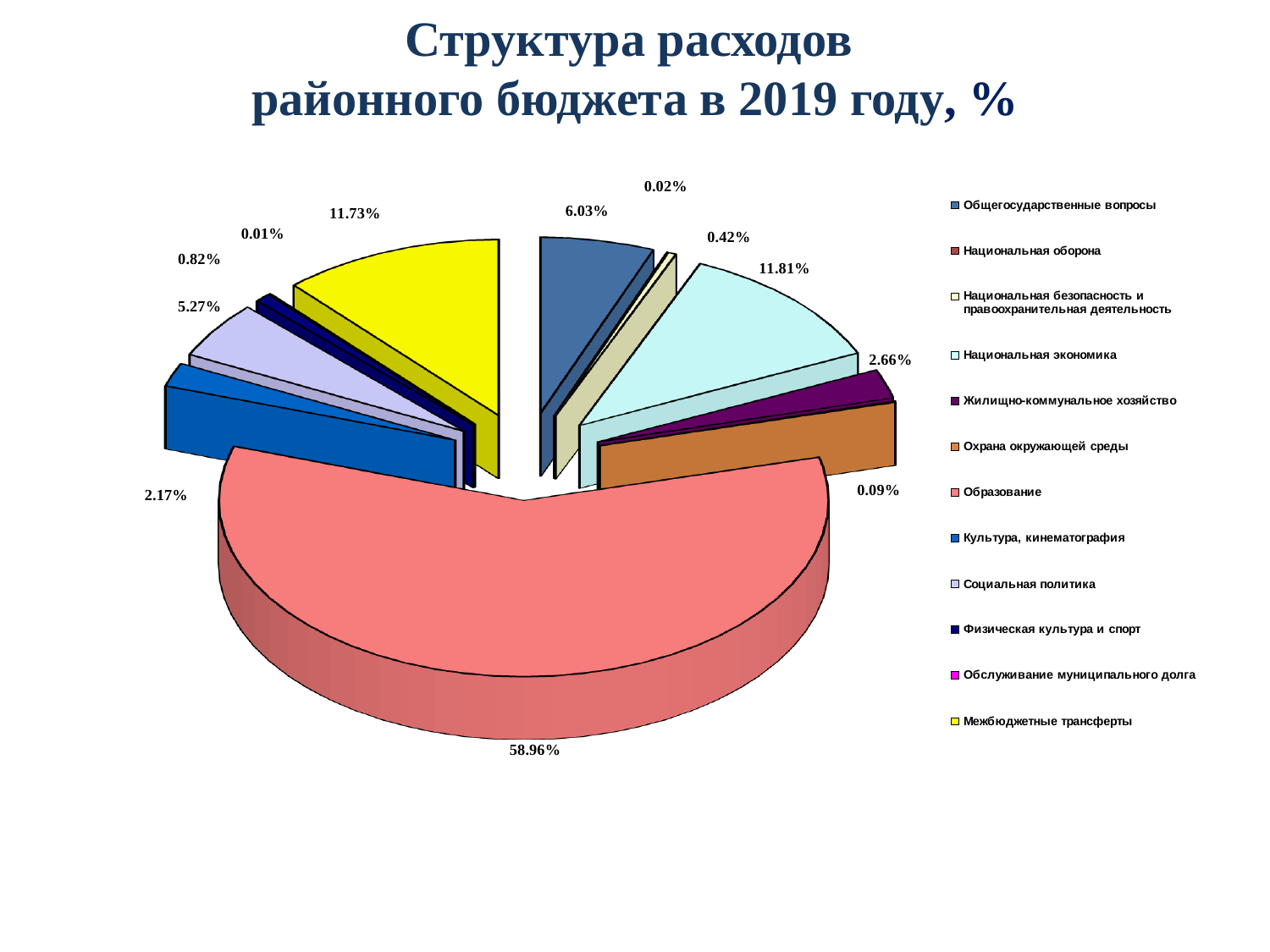
What is the value for Социальная политика? 5.27% What is the difference between the shares of Национальная экономика and Межбюджетные трансферты? 0.08% Which is larger, the share for Жилищно-коммунальное хозяйство or for Культура, кинематография? Жилищно-коммунальное хозяйство What is the value for Национальная экономика? 11.81% Which category has the largest share of expenditure? Образование What is the value for Межбюджетные трансферты? 11.73% How many categories does the legend list? 12 What is the title of the chart? Структура расходов районного бюджета в 2019 году, % Which category has the smallest share of expenditure? Обслуживание муниципального долга What is the value for Общегосударственные вопросы? 6.03% What type of chart is shown on the slide? pie chart What share of the 2019 district budget expenditure goes to Образование? 58.96%